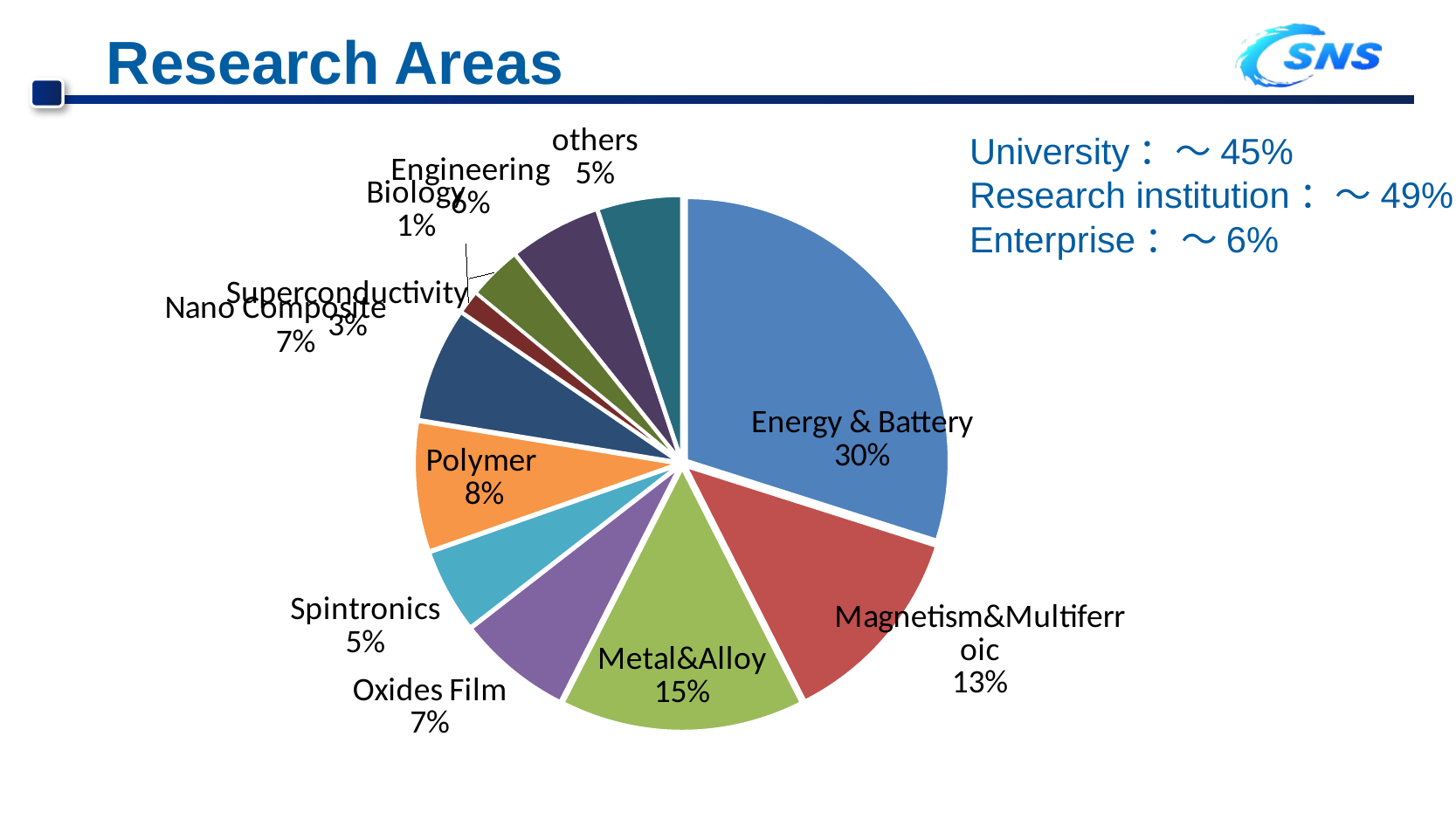
Which research area has the largest share of the pie? Energy & Battery What percentage is shown for Polymer? 8% What kind of chart is shown on the slide? pie chart What percentage is shown for Metal&Alloy? 15% How many research areas (slices) are shown in the pie chart? 11 What share of the pie does Energy & Battery have? 30% What percentage is shown for Spintronics? 5% What is the difference in percentage points between Energy & Battery and Metal&Alloy? 15 What percentage is shown for Magnetism&Multiferroic? 13% Which has a larger share, Polymer or Oxides Film? Polymer What is the title of the slide containing the pie chart? Research Areas Which research area has the smallest share of the pie? Biology